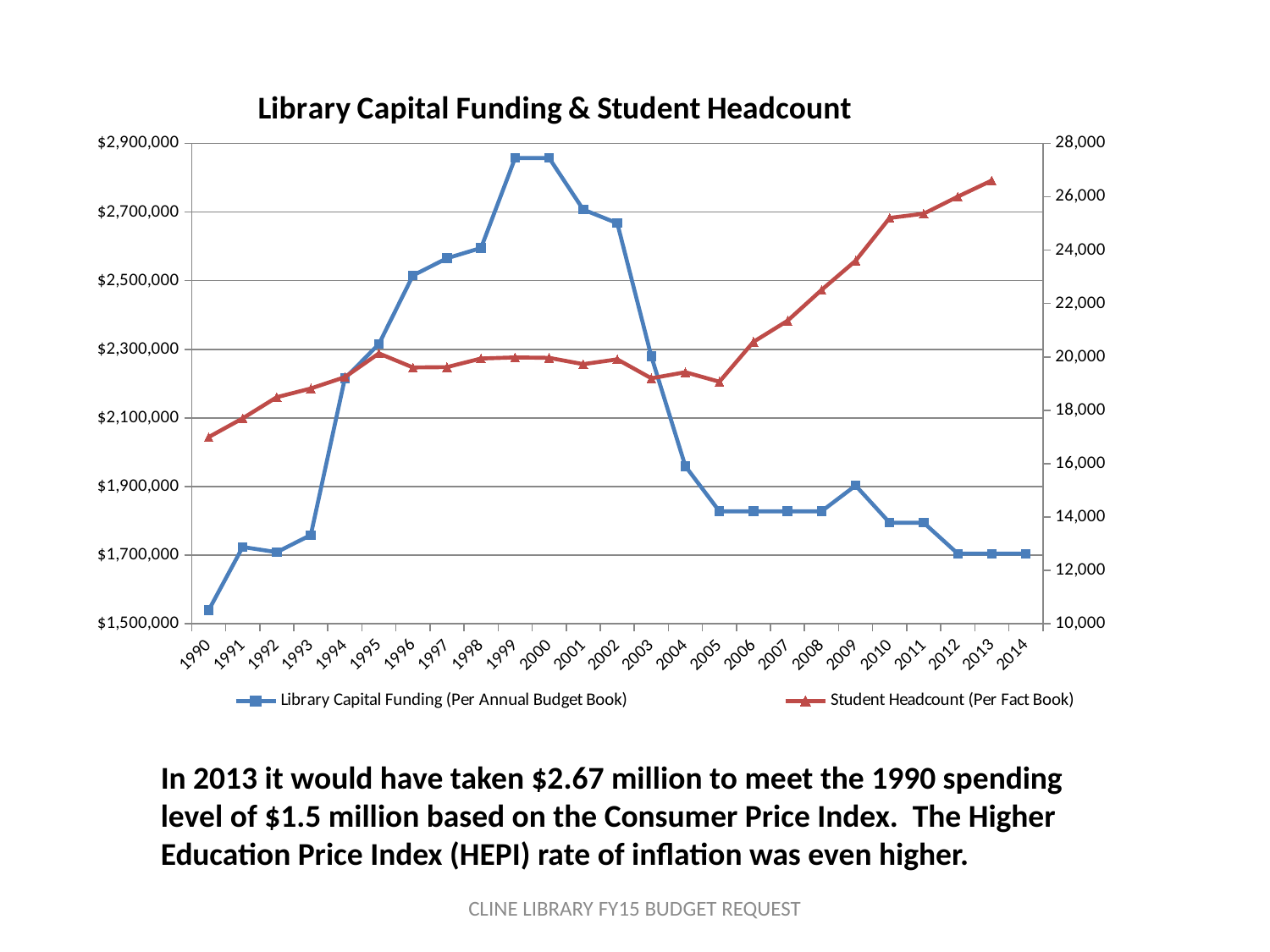
Does the Student Headcount rise or fall from 2005 to 2013? rise Is the Student Headcount value for 2013 greater or less than 26,000? greater Is the Student Headcount value for 1990 greater or less than 18,000? less Is the Library Capital Funding value for 1999 greater or less than $2,700,000? greater What kind of chart is shown on the slide? line chart Which year has the lowest Student Headcount (Per Fact Book)? 1990 Which year has the lowest Library Capital Funding (Per Annual Budget Book)? 1990 Which is larger, the Library Capital Funding for 2003 or for 2004? 2003 Which year has the highest Student Headcount (Per Fact Book)? 2013 How many years are shown on the x axis? 25 How many series does the legend list? 2